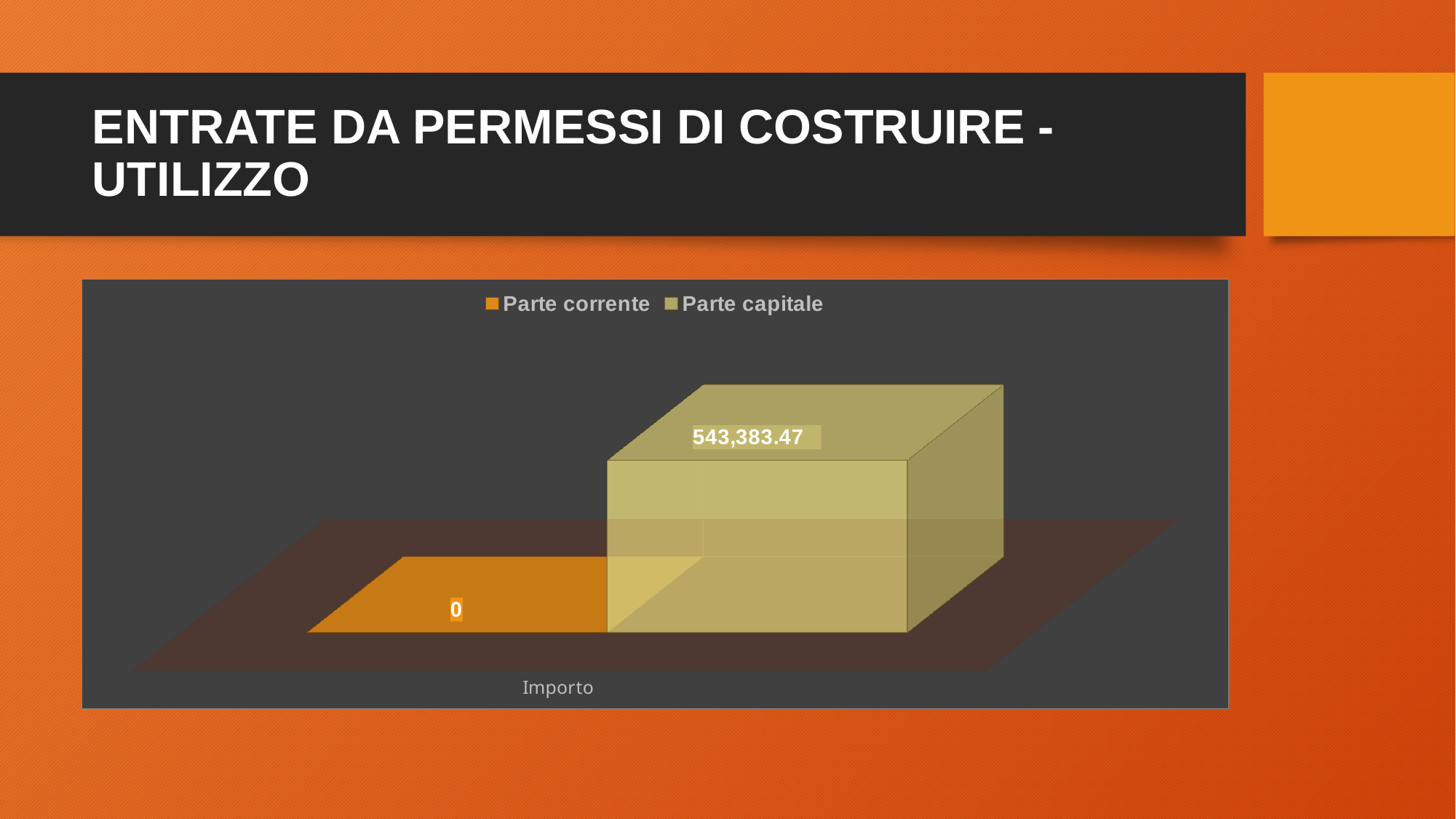
Which series has the highest value? Parte capitale What is the category label shown on the x axis? Importo What is the value for Parte capitale? 543,383.47 What is the title of the slide containing the chart? ENTRATE DA PERMESSI DI COSTRUIRE - UTILIZZO What is the value for Parte corrente? 0 What is the difference between the Parte capitale and Parte corrente values? 543,383.47 Which series has the higher value, Parte corrente or Parte capitale? Parte capitale What kind of chart is shown on the slide? Bar chart Which series has the lowest value? Parte corrente How many series does the legend list? 2 How many categories are shown on the x axis? 1